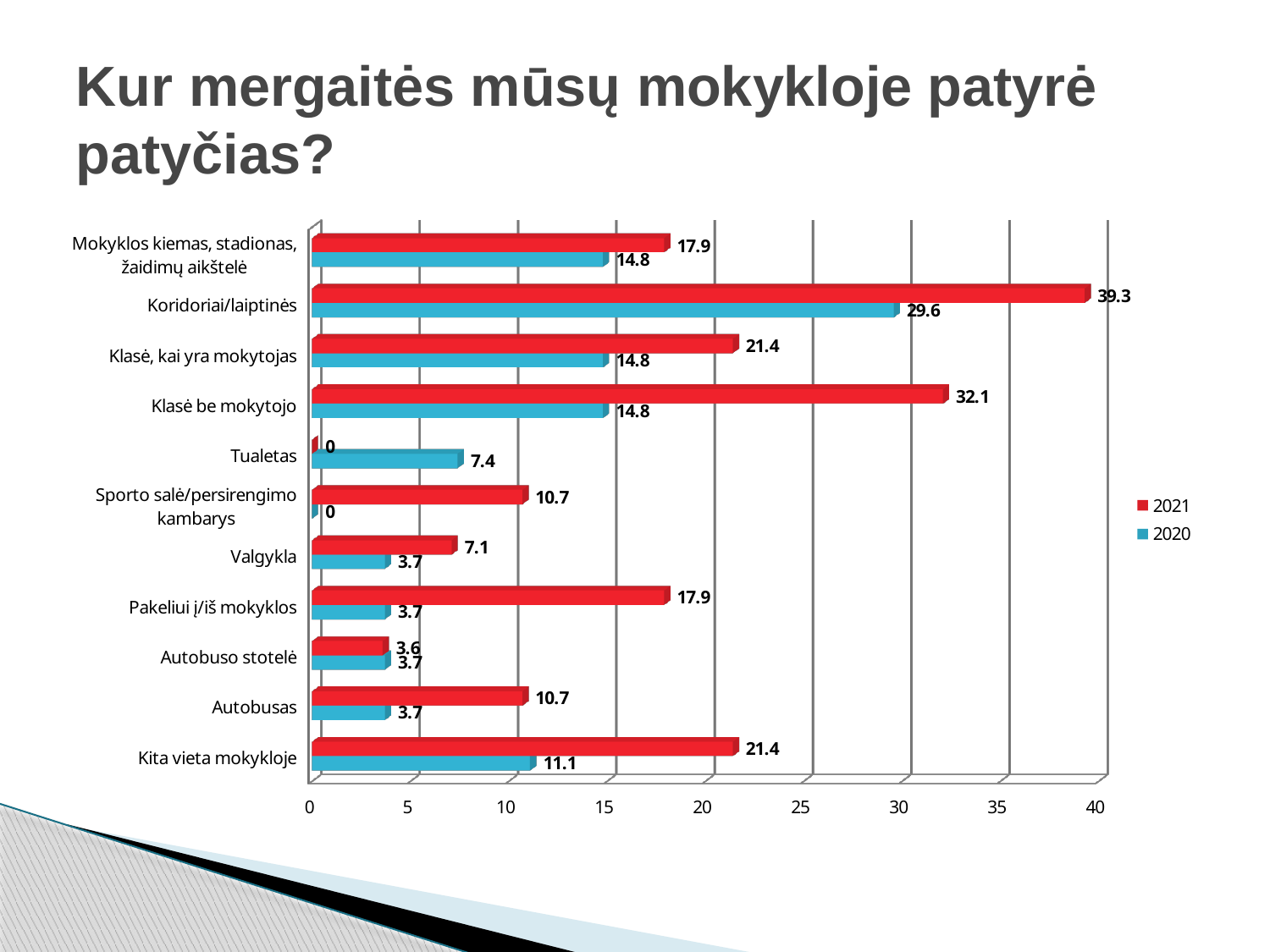
Which colour represents the 2020 series? Blue What is the 2021 value for Klasė be mokytojo? 32.1 How many series does the legend list? 2 What is the 2021 value for Koridoriai/laiptinės? 39.3 What kind of chart is shown on the slide? Bar chart Which category has the highest 2021 value? Koridoriai/laiptinės Which is larger for Pakeliui į/iš mokyklos: the 2021 value or the 2020 value? 2021 Which category has the lowest 2021 value? Tualetas What is the 2020 value for Tualetas? 7.4 How many categories are shown on the chart? 11 Is the 2020 value for Koridoriai/laiptinės greater or less than 25? greater What is the difference between the 2021 and 2020 values for Klasė be mokytojo? 17.3